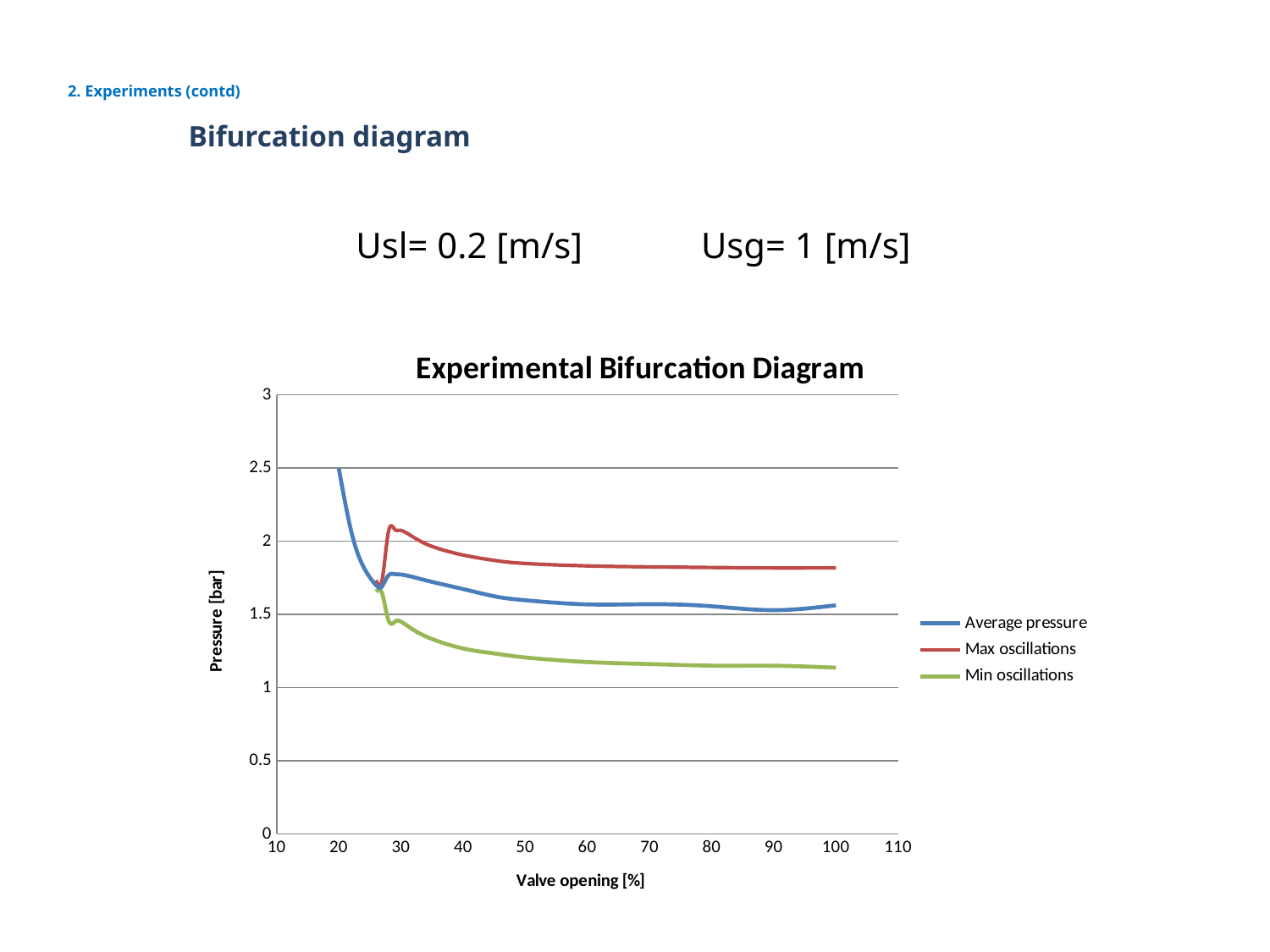
In the Experimental Bifurcation Diagram, at a valve opening of 60%, which is larger: Max oscillations or Min oscillations? Max oscillations In the Experimental Bifurcation Diagram, is the Min oscillations value at a valve opening of 100% greater or less than 1.5? less In the Experimental Bifurcation Diagram, at a valve opening of 100%, which is larger: Average pressure or Max oscillations? Max oscillations What kind of chart is the Experimental Bifurcation Diagram? line chart What is the label of the x axis of the Experimental Bifurcation Diagram? Valve opening [%] What are the three series listed in the legend of the Experimental Bifurcation Diagram? Average pressure, Max oscillations, Min oscillations In the Experimental Bifurcation Diagram, is the Min oscillations value at a valve opening of 50% greater or less than 1? greater In the Experimental Bifurcation Diagram, is the Max oscillations value at a valve opening of 100% greater or less than 1.5? greater In the Experimental Bifurcation Diagram, does the Min oscillations series generally rise or fall as valve opening increases from 30% to 100%? fall In the Experimental Bifurcation Diagram, does the Average pressure generally rise or fall as valve opening increases? fall How many series does the legend of the Experimental Bifurcation Diagram list? 3